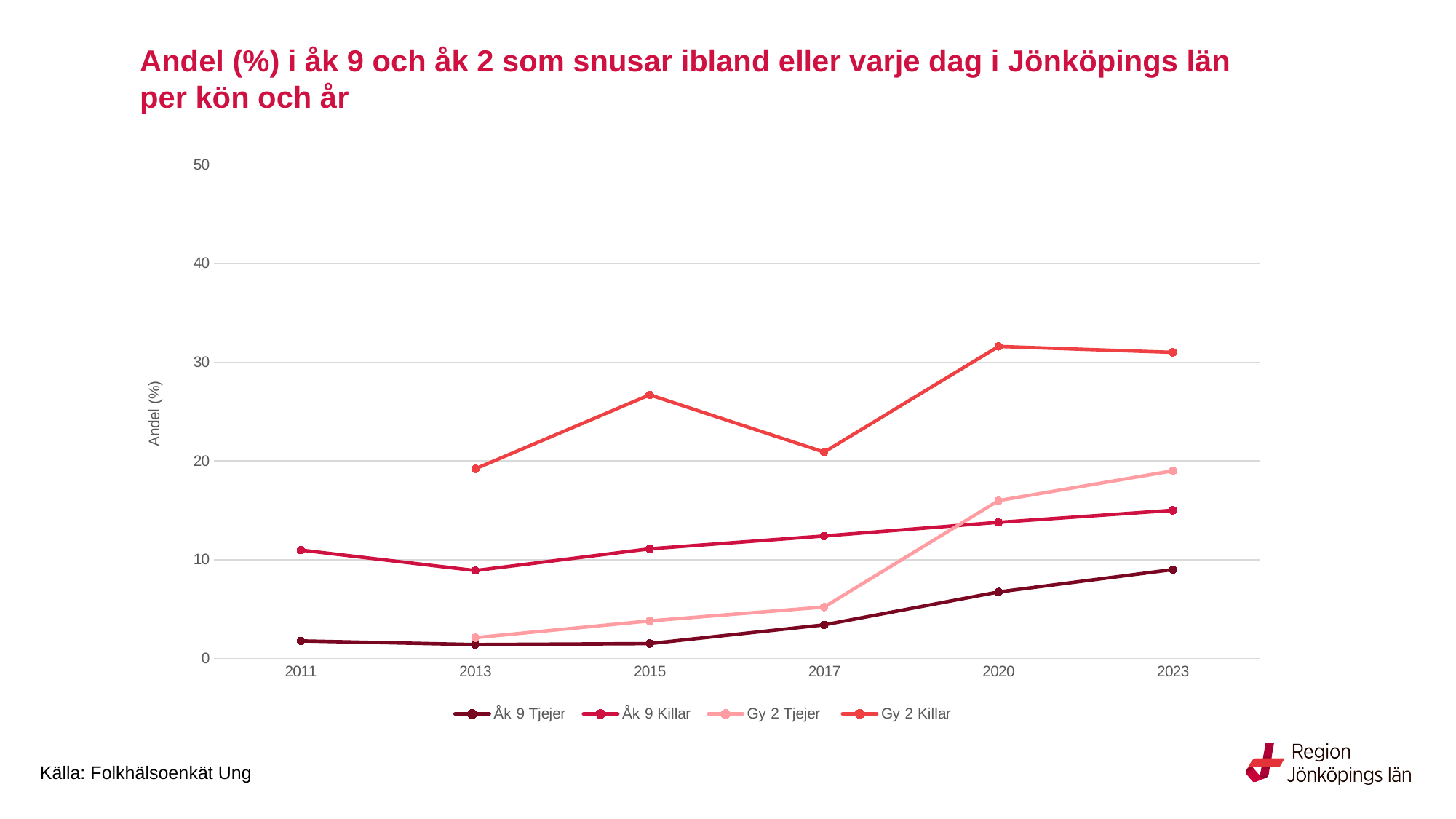
Is the value for Åk 9 Killar in 2011 greater or less than 10? greater How many series does the legend list? 4 Is the value for Gy 2 Tjejer in 2023 greater or less than 20? less Do the values for Åk 9 Tjejer rise or fall from 2015 to 2023? rise In 2020, which is larger: Gy 2 Tjejer or Åk 9 Killar? Gy 2 Tjejer How many years are shown on the x axis? 6 Which series has the lowest value in 2023? Åk 9 Tjejer In which year is the value for Gy 2 Killar lowest? 2013 Is the value for Gy 2 Killar in 2020 greater or less than 30? greater What is the label on the y axis? Andel (%) Which series has the highest value in 2023? Gy 2 Killar What kind of chart is shown on the slide? line chart